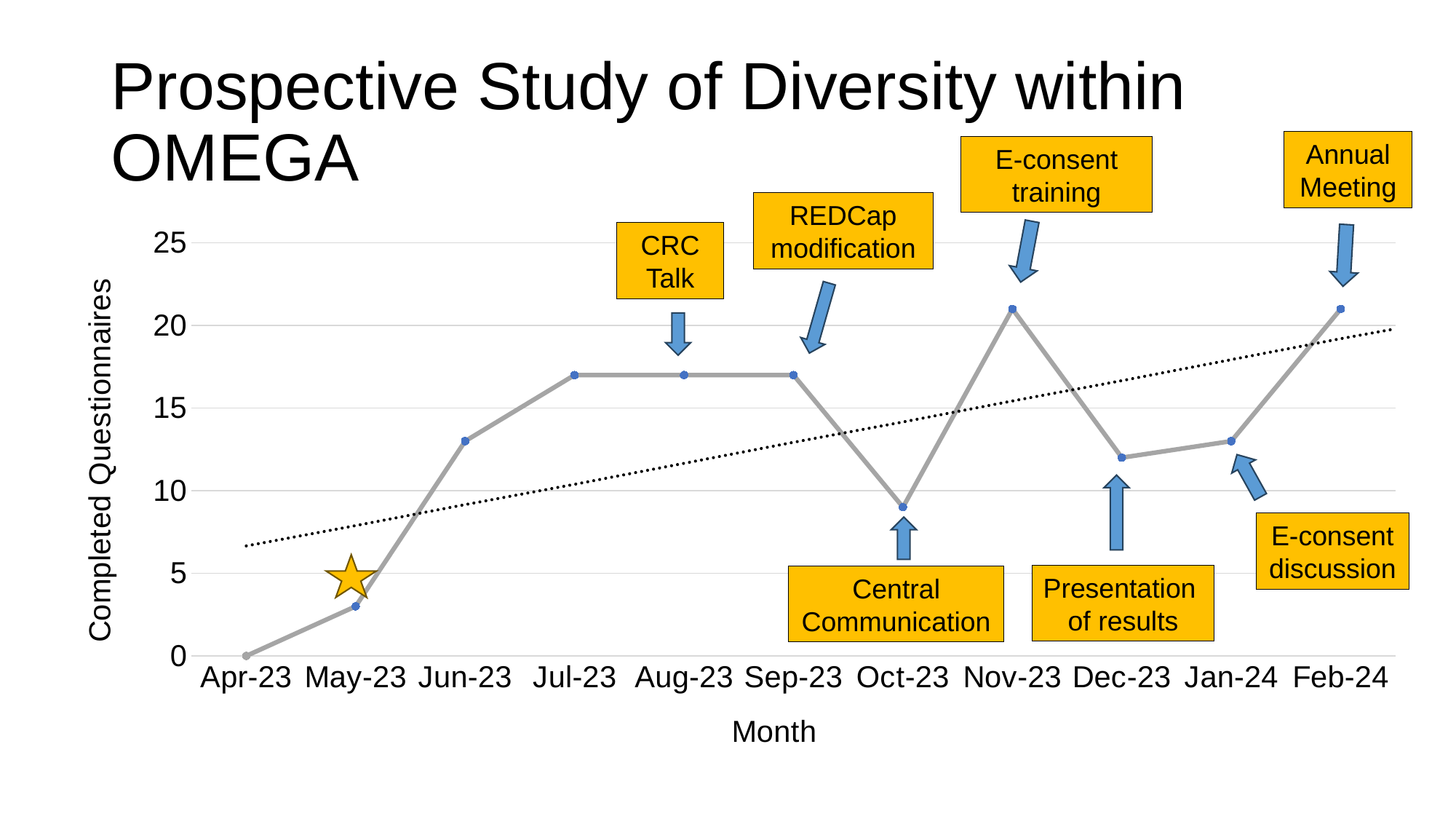
What kind of chart is shown on the slide? line chart Is the value for Jul-23 greater or less than 15? greater Is the value for Nov-23 greater or less than 20? greater Which month has more Completed Questionnaires, May-23 or Jun-23? Jun-23 Which month has more Completed Questionnaires, Oct-23 or Nov-23? Nov-23 Is the value for May-23 greater or less than 5? less Which month has the lowest number of Completed Questionnaires? Apr-23 What is the value of Completed Questionnaires for Apr-23? 0 How many months are plotted on the x axis? 11 Does the dotted trend line rise or fall from Apr-23 to Feb-24? rise What is the title of the y axis? Completed Questionnaires